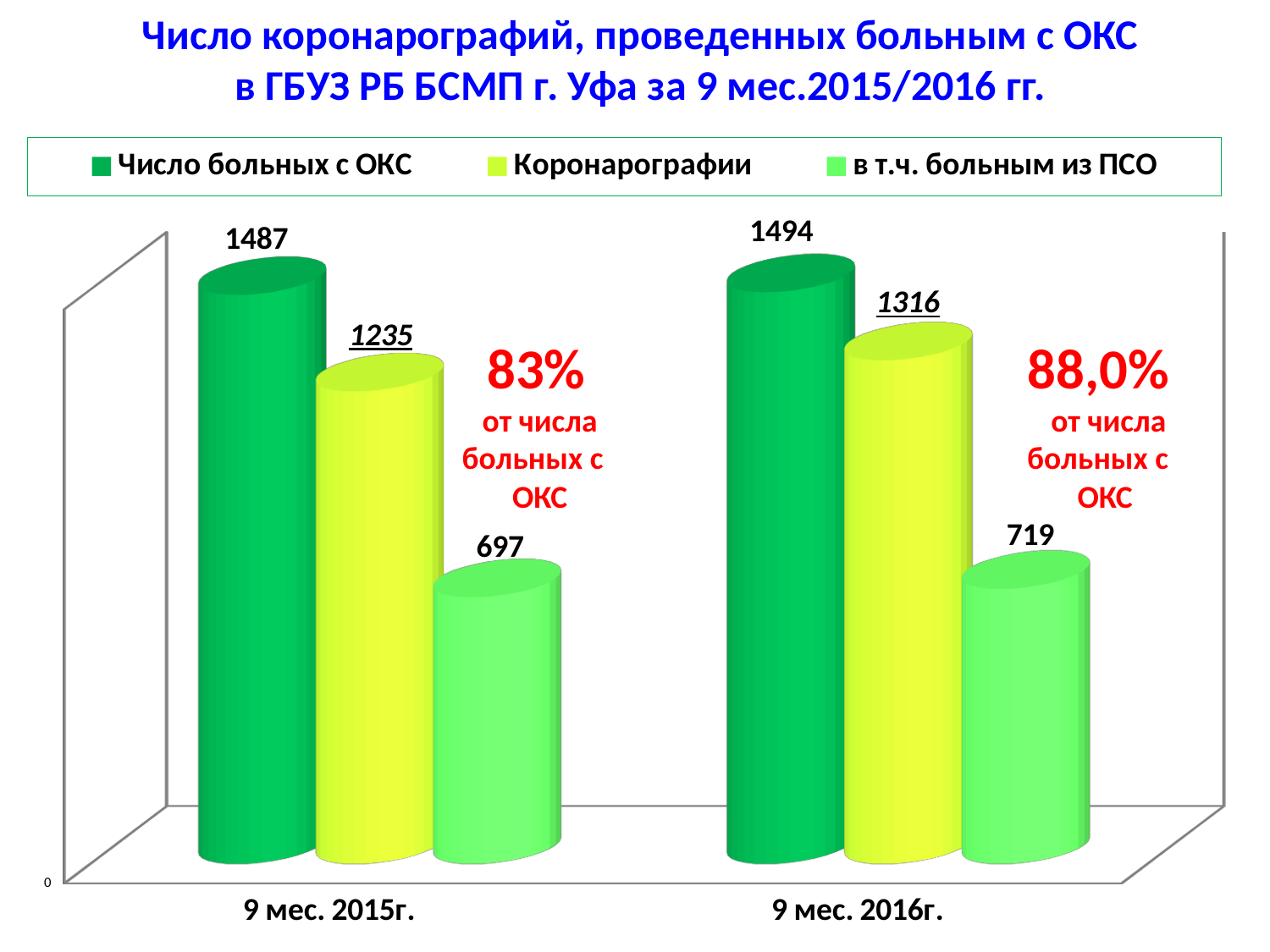
What is the value of "Число больных с ОКС" for "9 мес. 2016г."? 1494 What kind of chart is shown on the slide? bar chart Is "в т.ч. больным из ПСО" larger in "9 мес. 2015г." or "9 мес. 2016г."? 9 мес. 2016г. How many series does the legend list? 3 What is the value of "Коронарографии" for "9 мес. 2016г."? 1316 Which series has the lowest value for "9 мес. 2016г."? в т.ч. больным из ПСО What is the difference between "Коронарографии" in "9 мес. 2016г." and in "9 мес. 2015г."? 81 Which series has the highest value for "9 мес. 2015г."? Число больных с ОКС How many categories are shown on the x axis? 2 What is the difference between "Число больных с ОКС" and "Коронарографии" for "9 мес. 2015г."? 252 What is the value of "в т.ч. больным из ПСО" for "9 мес. 2015г."? 697 What is the value of "Число больных с ОКС" for "9 мес. 2015г."? 1487